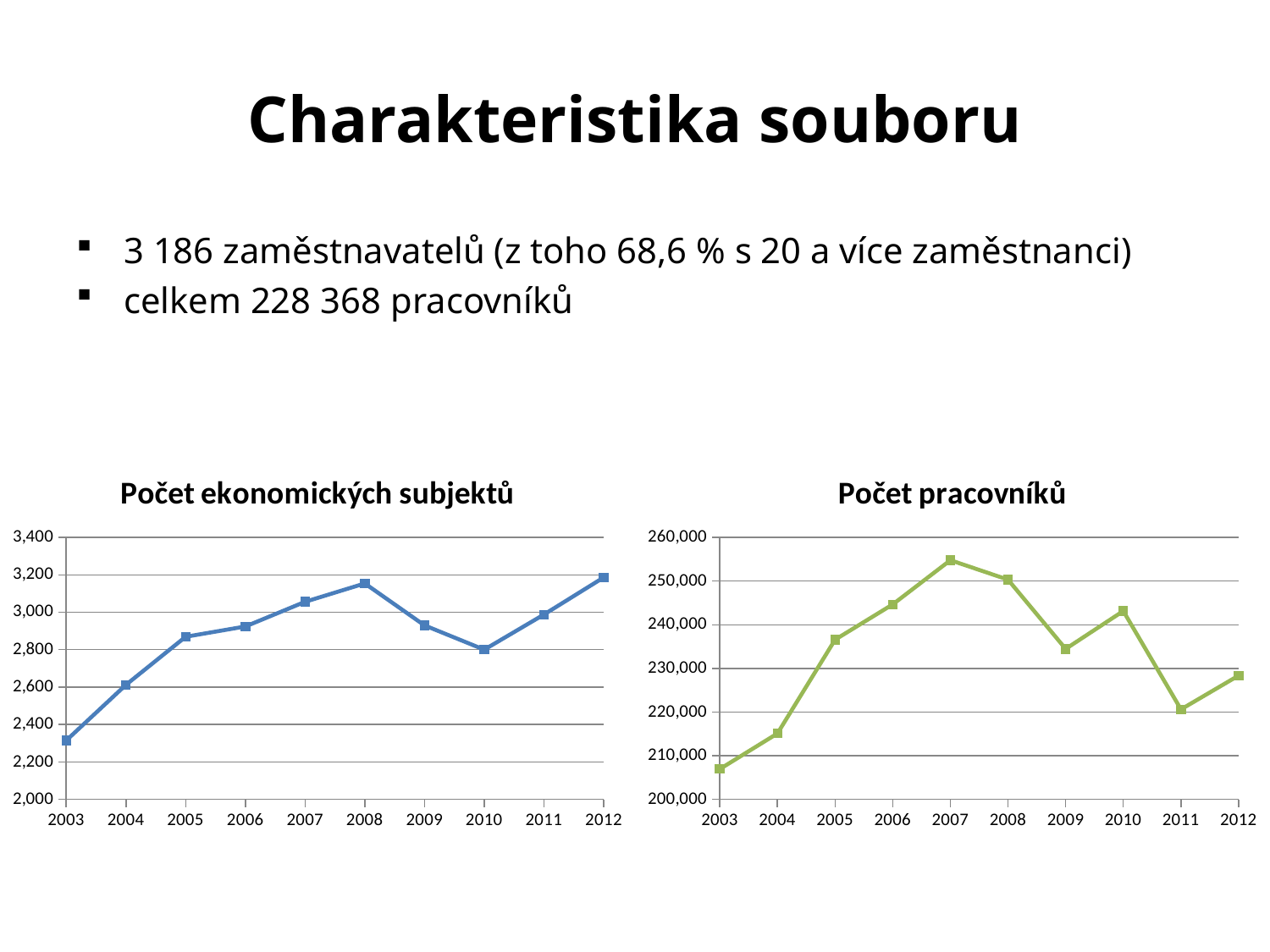
How many years are plotted in the "Počet pracovníků" chart on the right? 10 In the "Počet ekonomických subjektů" chart on the left, is the value for 2008 greater or less than 3,000? greater In the "Počet pracovníků" chart on the right, which year has the larger value, 2006 or 2009? 2006 In the "Počet ekonomických subjektů" chart on the left, which year has the larger value, 2004 or 2007? 2007 In the "Počet pracovníků" chart on the right, is the value for 2011 greater or less than 230,000? less What kind of chart is the "Počet ekonomických subjektů" chart on the left? line chart In the "Počet pracovníků" chart on the right, which year has the highest value? 2007 In the "Počet ekonomických subjektů" chart on the left, which year has the lowest value? 2003 In the "Počet pracovníků" chart on the right, which year has the lowest value? 2003 In the "Počet ekonomických subjektů" chart on the left, do the values rise or fall from 2003 to 2008? rise In the "Počet pracovníků" chart on the right, is the value for 2007 greater or less than 250,000? greater